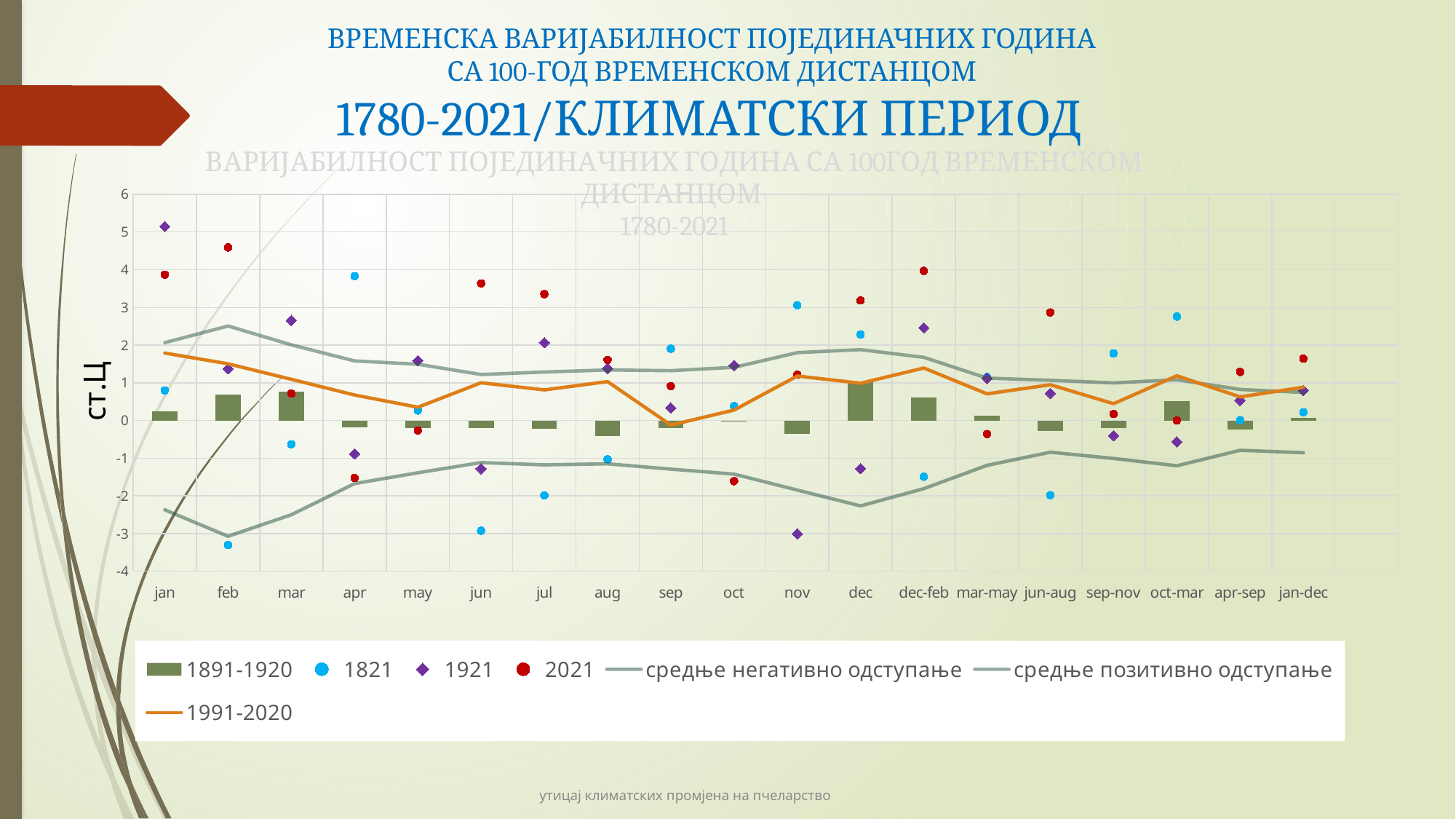
Is the value for 2021 in feb greater or less than 4? greater In jan, which is larger: the value for 1921 or the value for 2021? 1921 How many categories are shown along the x axis of the chart? 19 Is the value for 1821 in feb greater or less than -3? less What is the label on the vertical axis of the chart? ст.Ц Is the value for 1821 in apr greater or less than 3? greater What kind of chart is shown on the slide? A combination chart with bars, scatter points and lines In which category does the 1921 series reach its highest value? jan In which category does the 1821 series reach its lowest value? feb How many series does the chart legend list? 7